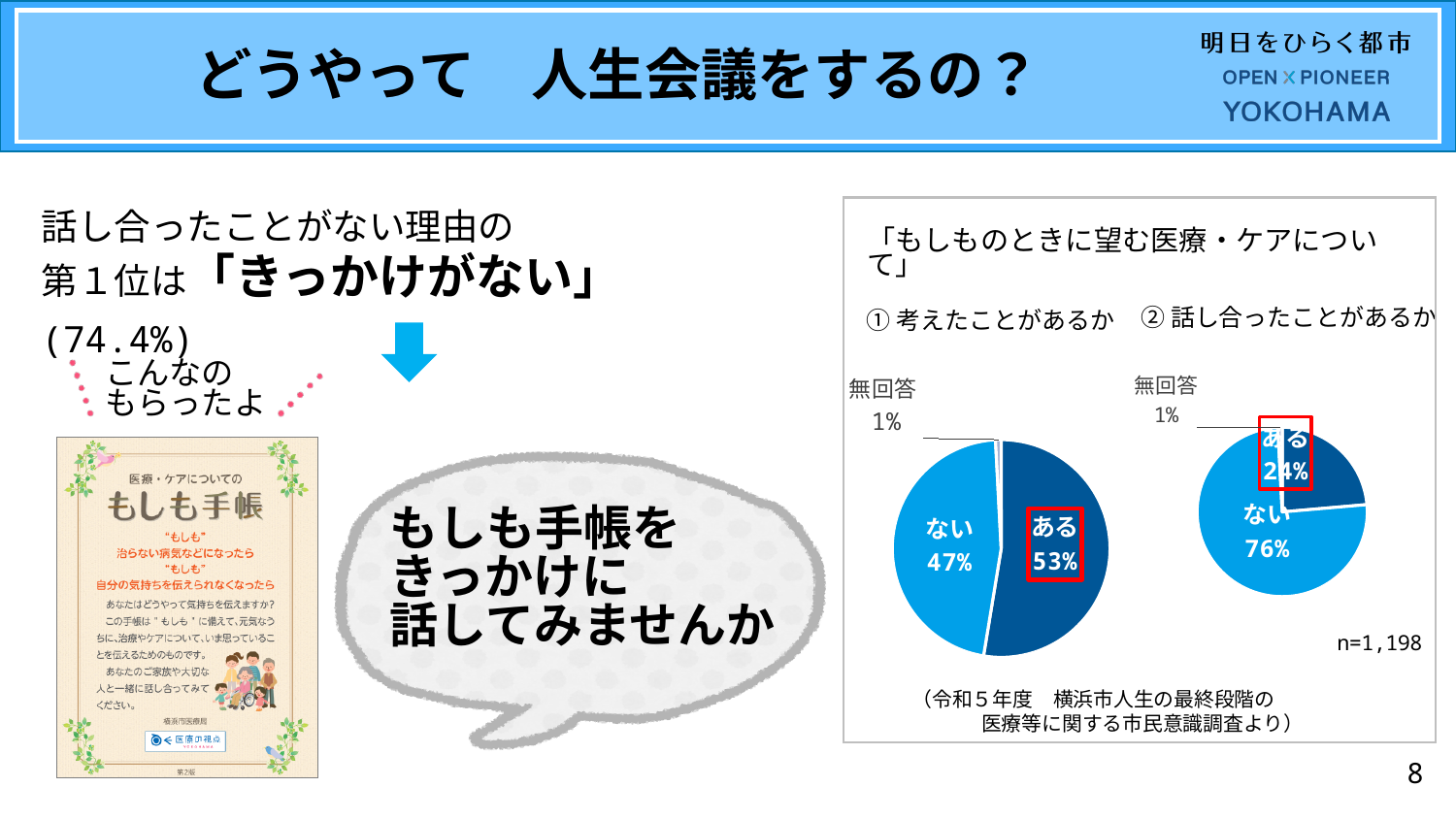
In the pie chart titled ②話し合ったことがあるか, which category has the largest slice? ない In the pie chart titled ①考えたことがあるか, what is the difference in percentage points between ある and ない? 6 In the pie chart titled ①考えたことがあるか, what percentage is shown for ある? 53% Which is larger: ある in the pie chart ①考えたことがあるか or ある in the pie chart ②話し合ったことがあるか? ある in ①考えたことがあるか What type of chart is used for ②話し合ったことがあるか? Pie chart How many slices does the pie chart titled ①考えたことがあるか have? 3 In the pie chart titled ②話し合ったことがあるか, what percentage is shown for ない? 76% In the pie chart titled ②話し合ったことがあるか, what percentage is shown for ある? 24% In the pie chart titled ①考えたことがあるか, what percentage is shown for ない? 47% In the pie chart titled ②話し合ったことがあるか, what is the difference in percentage points between ない and ある? 52 In the pie chart titled ②話し合ったことがあるか, what percentage is shown for 無回答? 1% In the pie chart titled ①考えたことがあるか, which category has the smallest slice? 無回答